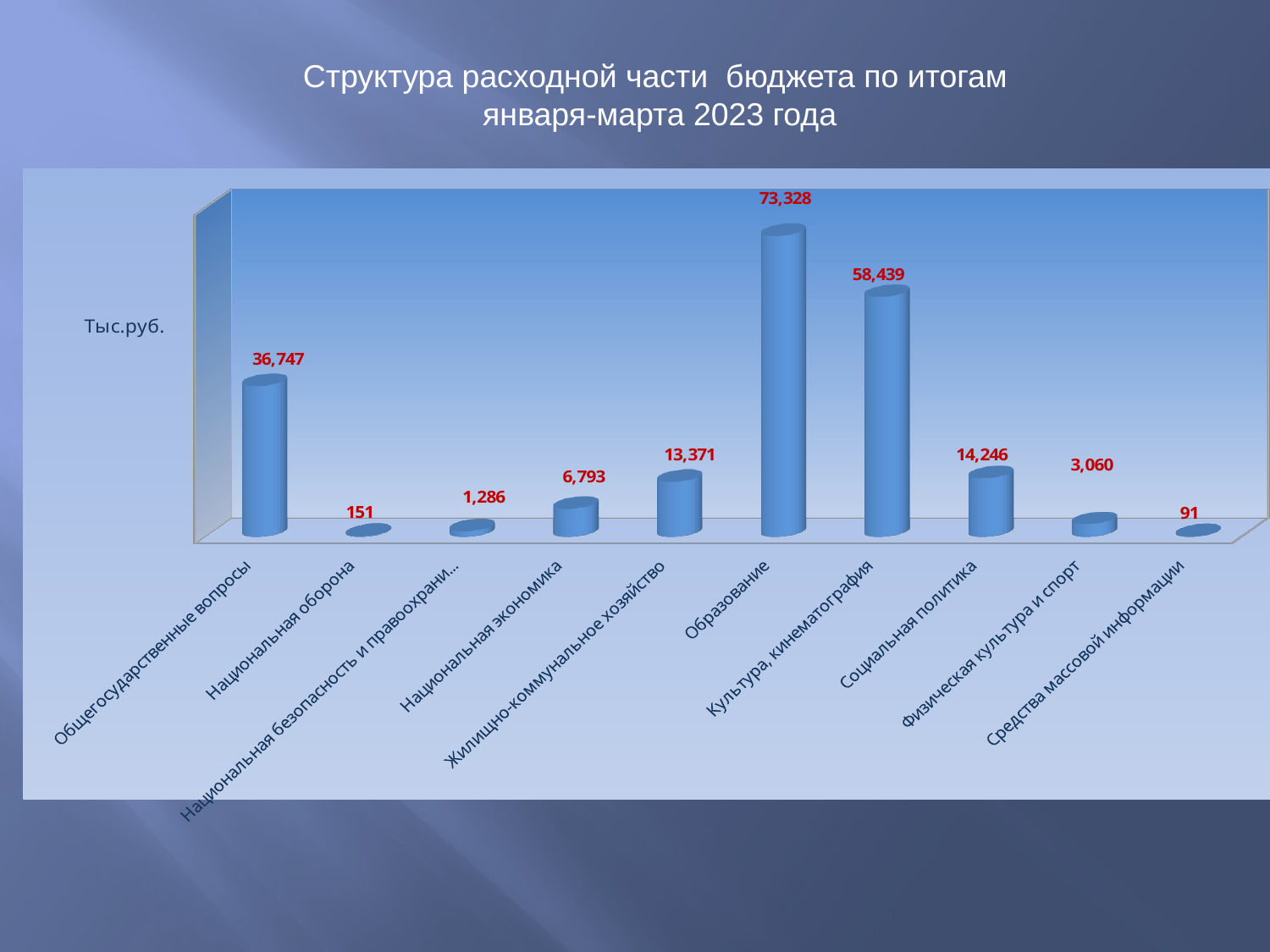
What is the value for Социальная политика? 14,246 What unit is indicated for the values in the chart? Тыс.руб. Which is larger, the value for Социальная политика or the value for Жилищно-коммунальное хозяйство? Социальная политика Which category has the lowest value? Средства массовой информации What is the difference between the values for Образование and Культура, кинематография? 14,889 What is the value for Общегосударственные вопросы? 36,747 What kind of chart is shown on the slide? Bar chart What is the difference between the values for Национальная экономика and Физическая культура и спорт? 3,733 Which category has the highest value? Образование What is the value for Образование? 73,328 What is the value for Культура, кинематография? 58,439 How many categories are shown in the chart? 10